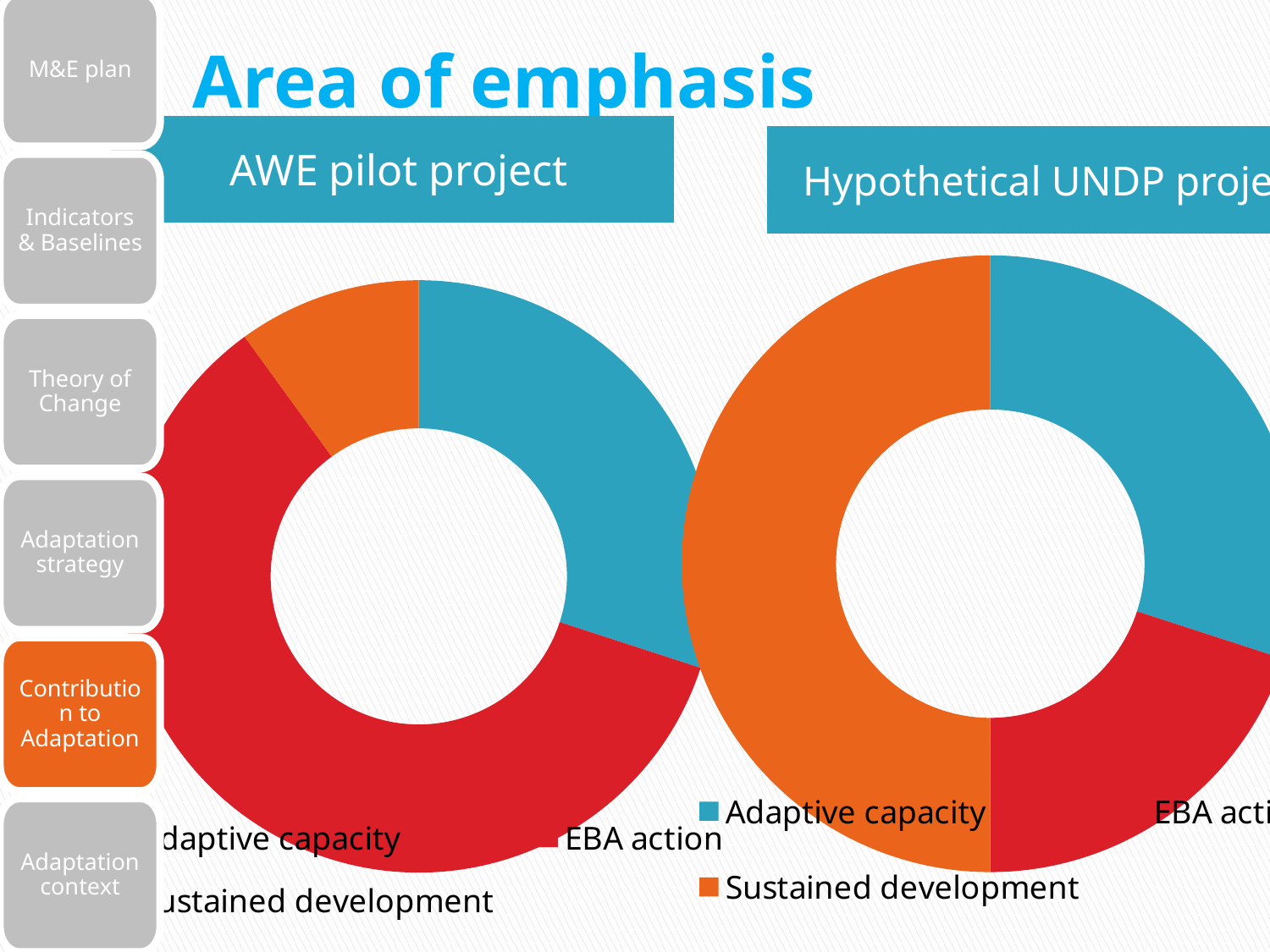
What kind of chart is the AWE pilot project chart on the left? Doughnut chart How many categories does the legend of the AWE pilot project chart list? 3 In the chart on the right, which slice is larger: Adaptive capacity or EBA action? Adaptive capacity In the AWE pilot project chart, which slice is larger: Adaptive capacity or Sustained development? Adaptive capacity What colour represents EBA action in the charts? Red In the AWE pilot project chart, which category has the largest slice? EBA action In the chart on the right, which category has the smallest slice? EBA action What kind of chart is the chart on the right of the slide? Doughnut chart In the AWE pilot project chart, which category has the smallest slice? Sustained development In the chart on the right, which category has the largest slice? Sustained development What is the title of the chart on the left? AWE pilot project How many slices does the chart on the right have? 3